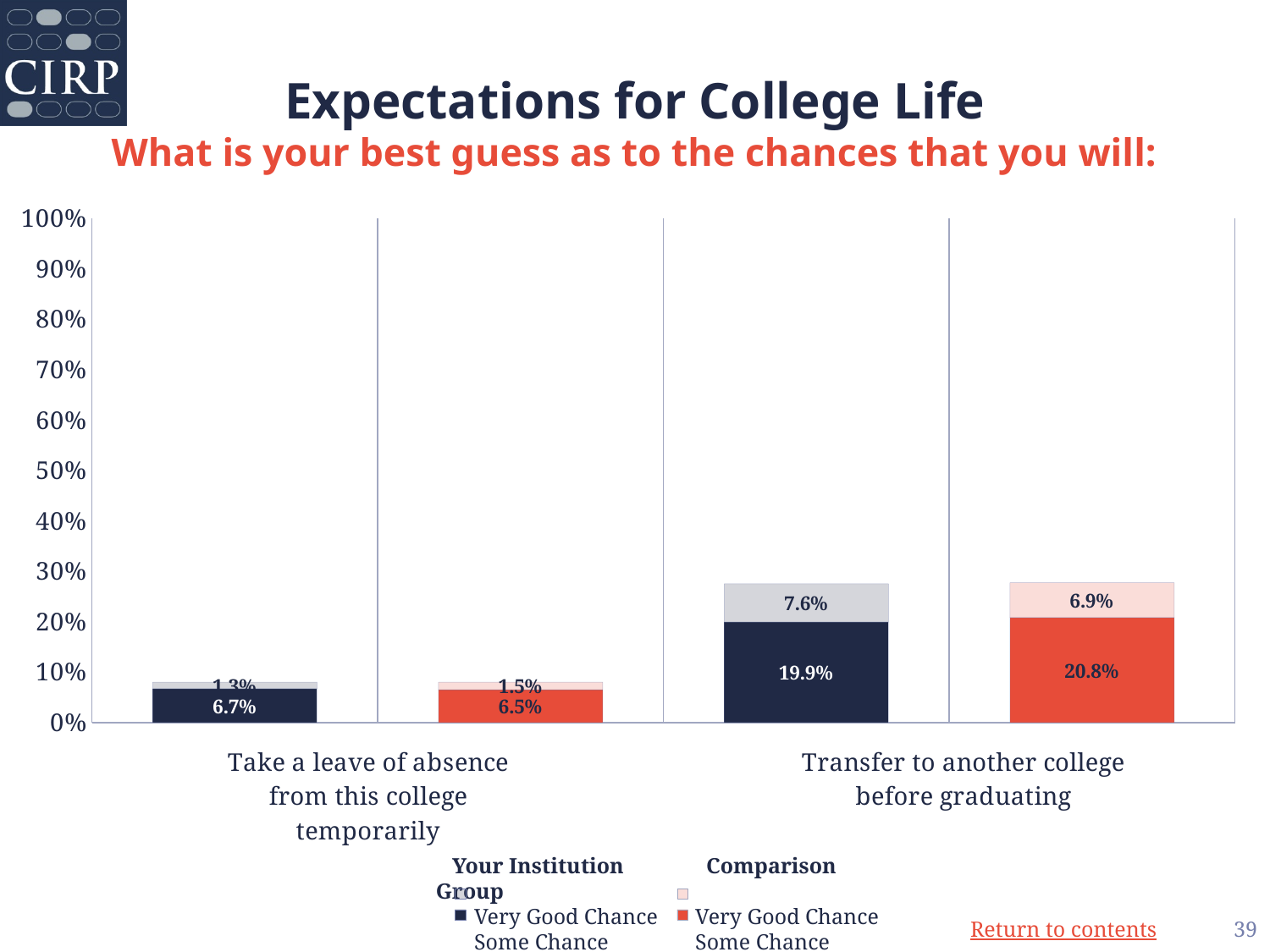
What is the Very Good Chance value for the Comparison Group for 'Transfer to another college before graduating'? 6.9% What is the total stacked value for the Comparison Group for 'Transfer to another college before graduating'? 27.7% What is the Some Chance value for the Comparison Group for 'Take a leave of absence from this college temporarily'? 6.5% How many series does the legend list? 4 What is the difference between the Comparison Group's and Your Institution's Very Good Chance values for 'Transfer to another college before graduating'? 0.7% What is the Some Chance value for Your Institution for 'Transfer to another college before graduating'? 19.9% What is the Very Good Chance value for Your Institution for 'Transfer to another college before graduating'? 7.6% What is the total stacked value for Your Institution for 'Transfer to another college before graduating'? 27.5% What kind of chart is shown on the slide? Stacked bar chart How many categories are shown on the x axis of the chart? 2 Which is larger for 'Transfer to another college before graduating': the Very Good Chance value for Your Institution or for the Comparison Group? Your Institution What is the Very Good Chance value for Your Institution for 'Take a leave of absence from this college temporarily'? 1.3%